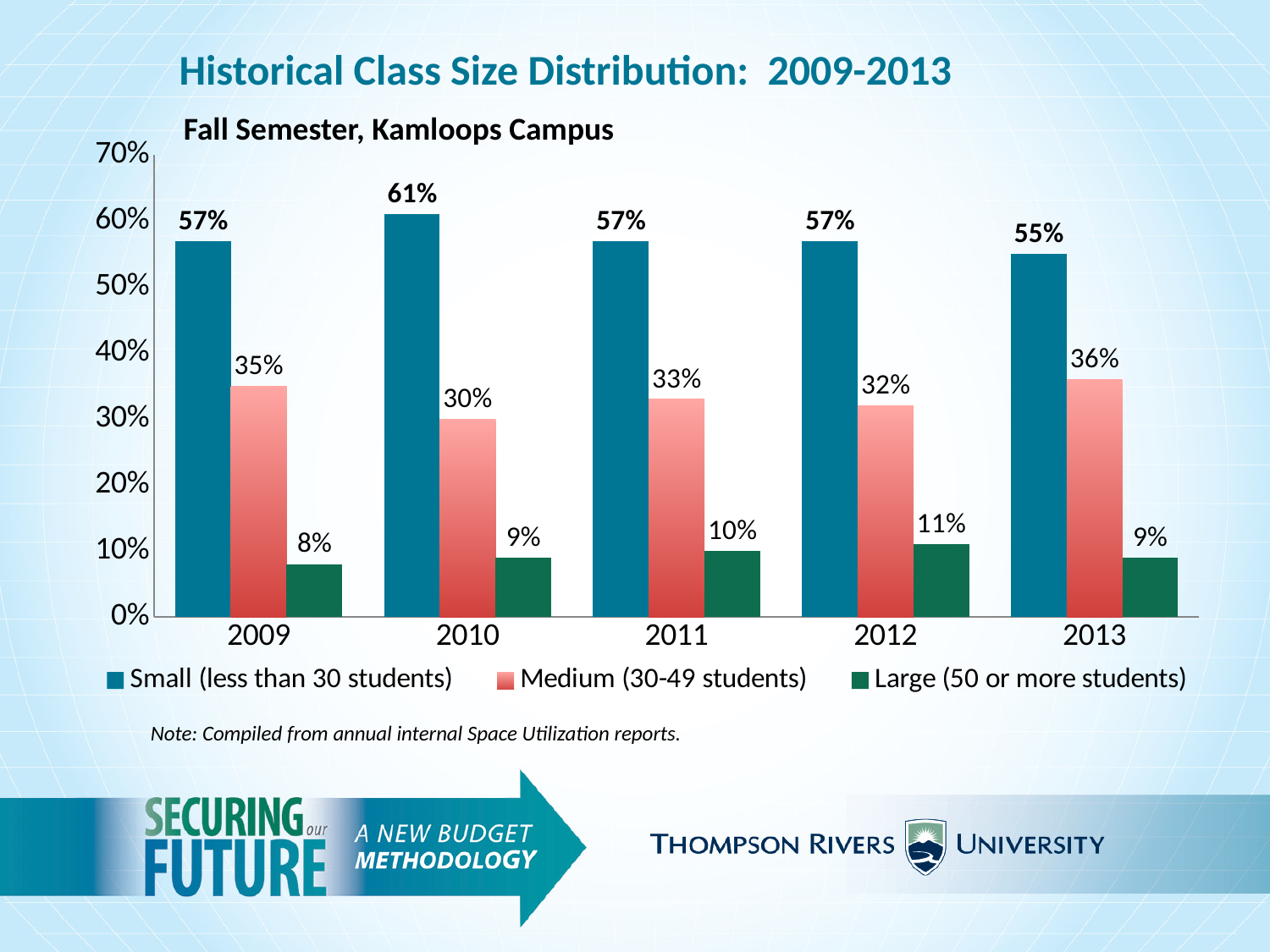
What percentage of classes were Large (50 or more students) in 2012? 11% How many series does the legend list? 3 What kind of chart is shown on the slide? Bar chart What is the difference between the Small and Medium class shares in 2011? 24% What is the subtitle shown above the chart? Fall Semester, Kamloops Campus What percentage of classes were Small (less than 30 students) in 2010? 61% Did the share of Medium (30-49 students) classes rise or fall from 2010 to 2013? Rise How many years are shown on the x axis? 5 In which year was the share of Large (50 or more students) classes lowest? 2009 Which was larger in 2012: the Medium (30-49 students) share or the Large (50 or more students) share? Medium (30-49 students) In which year was the share of Small (less than 30 students) classes highest? 2010 What percentage of classes were Medium (30-49 students) in 2013? 36%